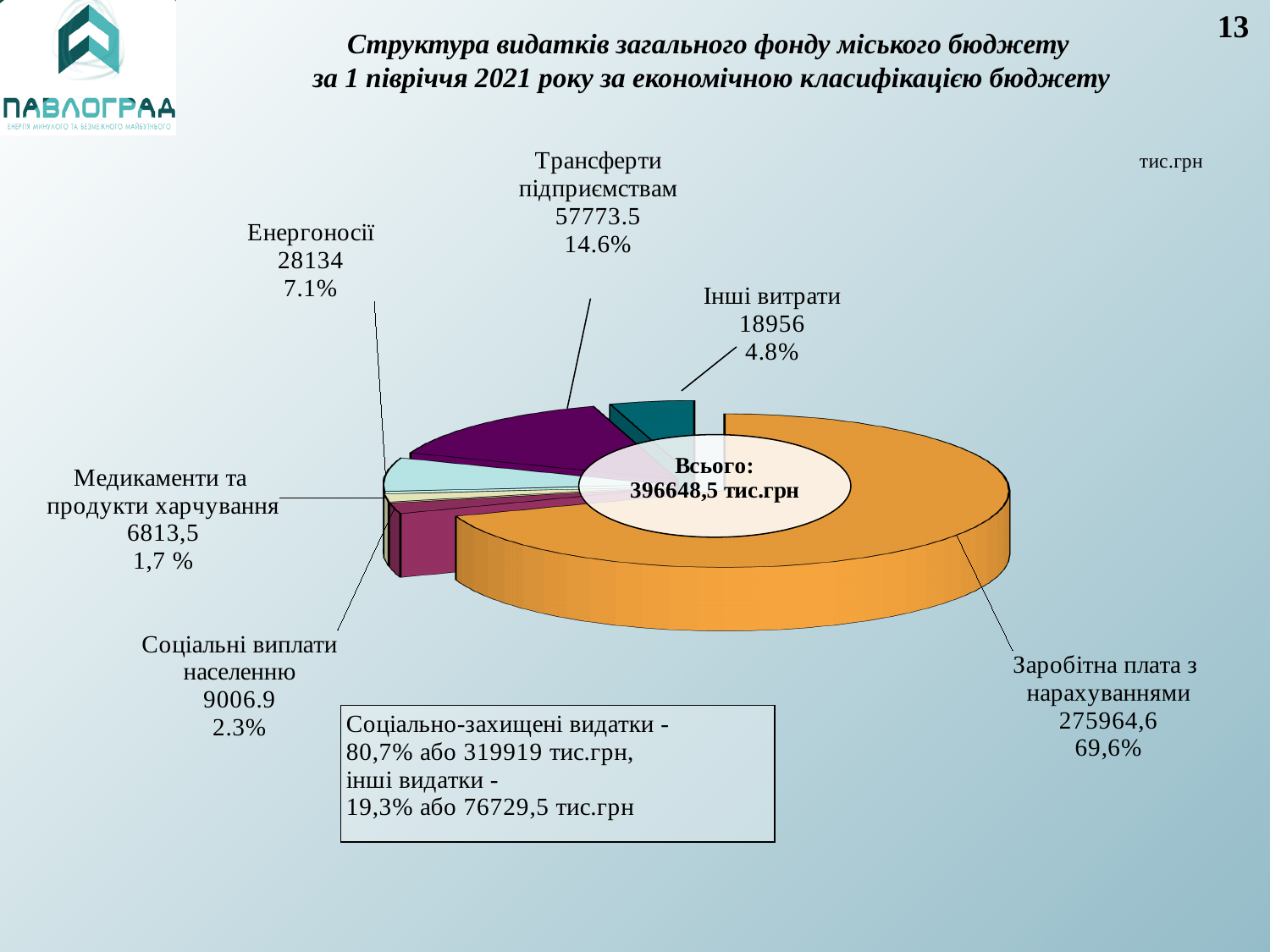
Which category has the largest share of the pie? Заробітна плата з нарахуваннями What share of the pie does "Трансферти підприємствам" represent? 14.6% What is the value for "Соціальні виплати населенню"? 9006.9 How many categories are shown in the pie chart? 6 What share of the pie does "Медикаменти та продукти харчування" represent? 1,7 % What total is shown in the centre of the pie chart? 396648,5 тис.грн What type of chart is shown on the slide? pie chart What share of the pie does "Інші витрати" represent? 4.8% Which is larger, the value for "Енергоносії" or the value for "Інші витрати"? Енергоносії What is the value for "Енергоносії"? 28134 What is the value for "Заробітна плата з нарахуваннями"? 275964,6 Which category has the smallest share of the pie? Медикаменти та продукти харчування